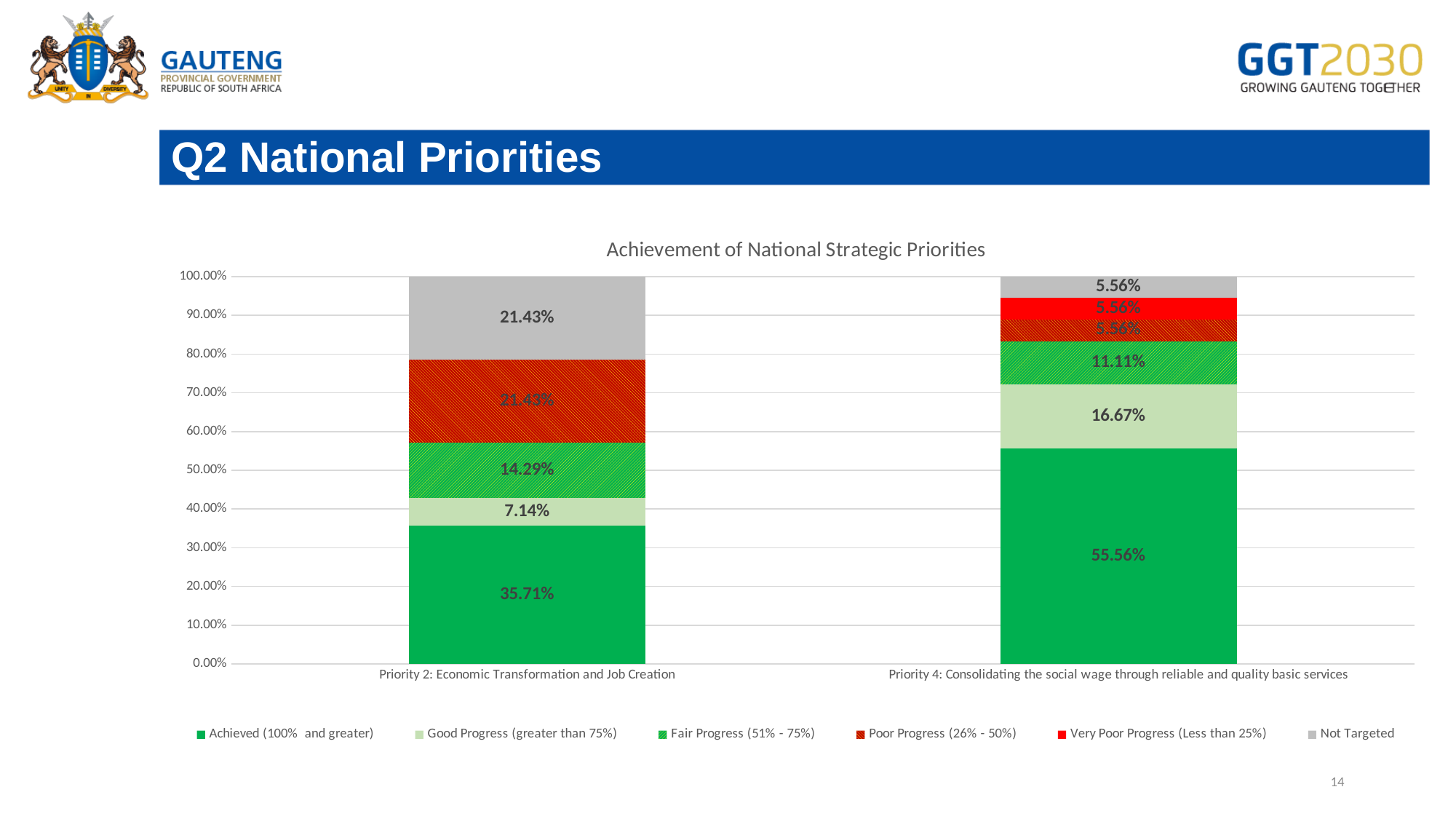
What is the Achieved (100% and greater) value for Priority 4: Consolidating the social wage through reliable and quality basic services? 55.56% Which priority has the higher Achieved (100% and greater) share, Priority 2 or Priority 4? Priority 4 How many series does the legend list? 6 What is the title of the chart? Achievement of National Strategic Priorities What type of chart is shown on the slide? Stacked bar chart What is the Not Targeted value for Priority 2? 21.43% What is the Good Progress (greater than 75%) value for Priority 4? 16.67% What is the Achieved (100% and greater) value for Priority 2: Economic Transformation and Job Creation? 35.71% What is the Fair Progress (51% - 75%) value for Priority 2? 14.29% What is the difference between the Achieved values for Priority 4 and Priority 2? 19.85% Which segment is the largest in the Priority 2 bar? Achieved (100% and greater) How many priority categories are plotted on the x axis? 2